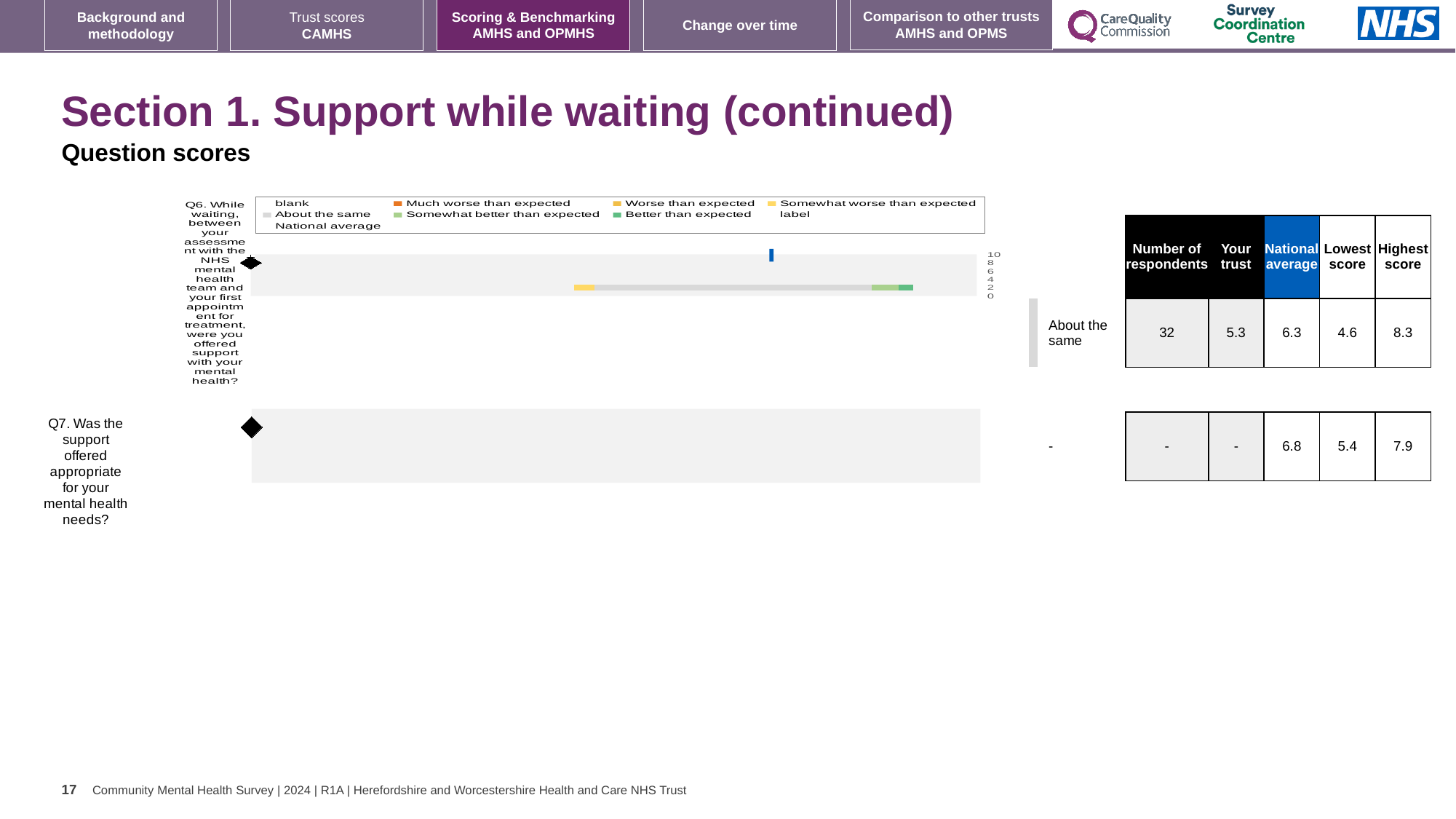
What is the national average score for Q6? 6.3 What is the difference between the highest score and the lowest score for Q6? 3.7 How many questions (Q6 and Q7) are plotted on the chart? 2 For Q6, which is larger: the 'Your trust' score or the national average? National average What benchmark category is shown for Q6? About the same How many respondents are recorded for Q6? 32 What is the lowest score shown for Q7? 5.4 What kind of chart is used to show the question scores on this slide? bar chart What is the highest score shown for Q6? 8.3 What is the national average score for Q7? 6.8 What colour represents 'Much worse than expected' in the chart legend? Orange What is the 'Your trust' score for Q6? 5.3